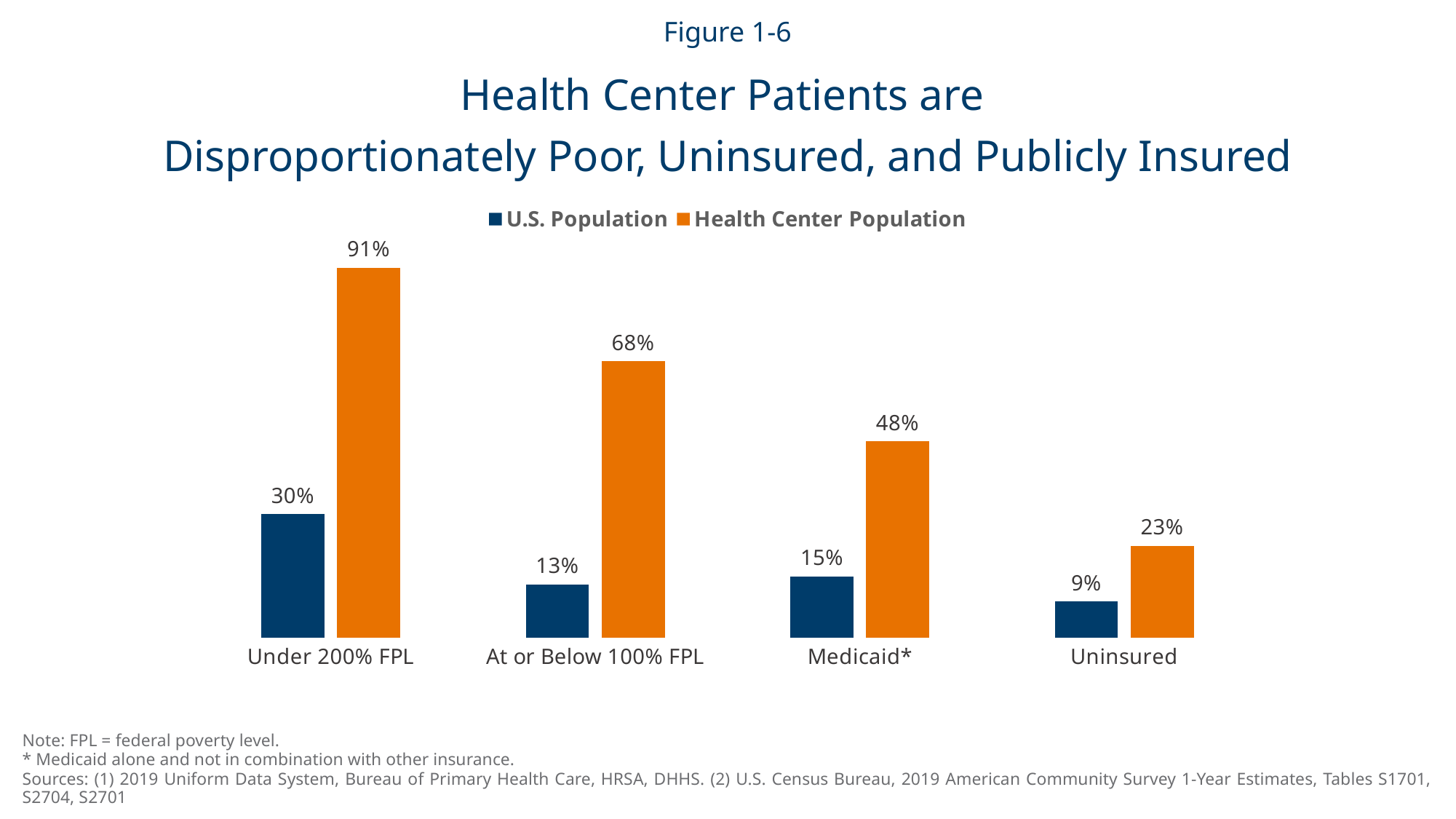
Which category has the highest Health Center Population value? Under 200% FPL What is the U.S. Population value for Uninsured? 9% What is the difference between the Health Center Population and U.S. Population values for Medicaid*? 33% Which colour represents the Health Center Population series? Orange Which is larger for Uninsured: the U.S. Population value or the Health Center Population value? Health Center Population What is the Health Center Population value for Under 200% FPL? 91% What is the Health Center Population value for At or Below 100% FPL? 68% How many categories are shown on the x axis? 4 Which category has the lowest U.S. Population value? Uninsured What is the U.S. Population value for Medicaid*? 15% What kind of chart is shown on the slide? Bar chart How many series does the legend list? 2